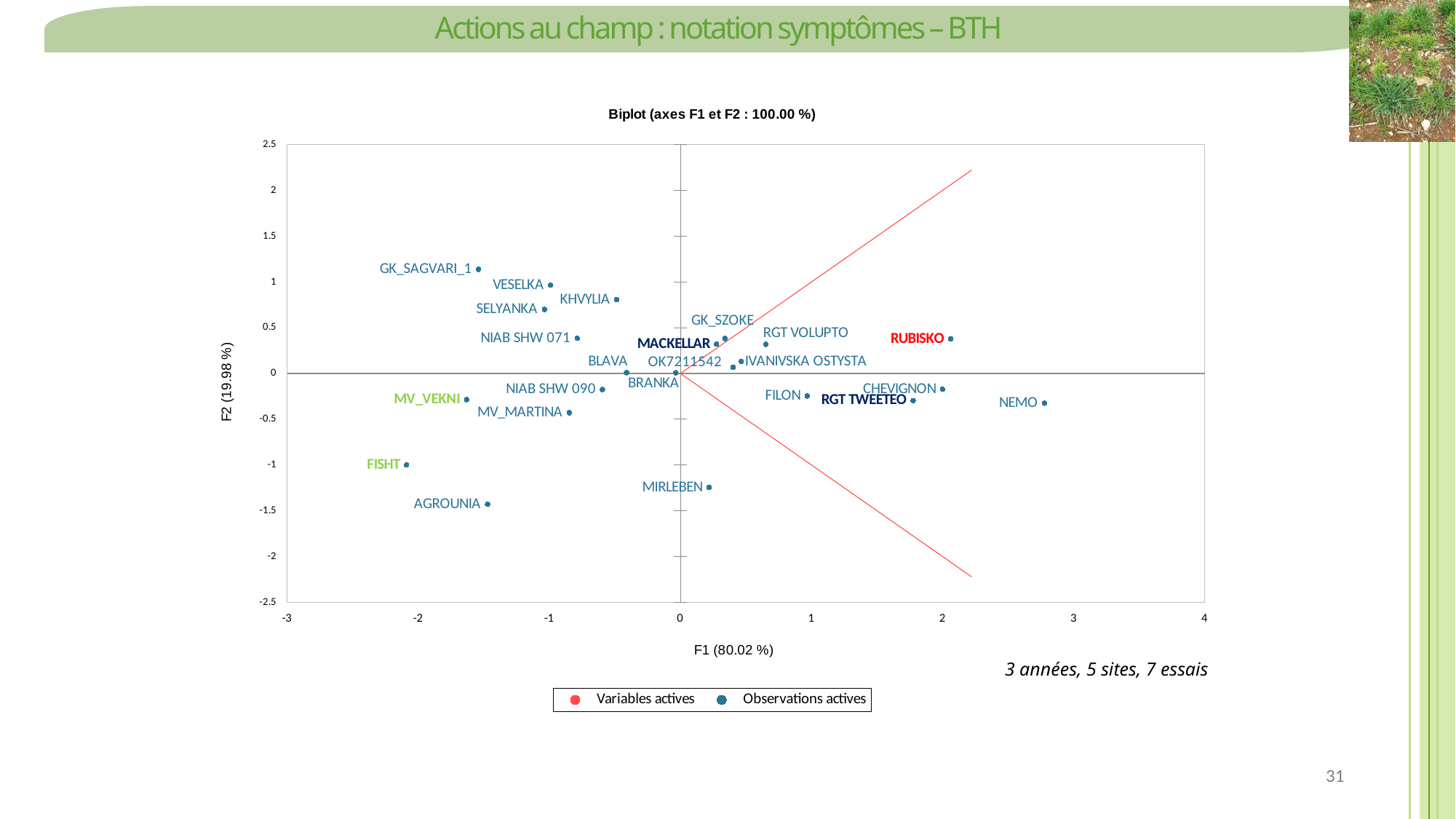
What is the title of the chart? Biplot (axes F1 et F2 : 100.00 %) What is the label of the horizontal axis? F1 (80.02 %) How many entries does the chart legend list? 2 Which labelled point has the lowest F2 value? AGROUNIA Is the F1 value for NEMO greater or less than 2? greater Is the F2 value for KHVYLIA greater or less than 0.5? greater What kind of chart is shown on the slide? Scatter plot (biplot) Which has the higher F2 value, GK_SAGVARI_1 or MIRLEBEN? GK_SAGVARI_1 Which labelled point has the highest F1 value? NEMO Which labelled point has the lowest F1 value? FISHT Which has the higher F1 value, FISHT or RUBISKO? RUBISKO Is the F2 value for AGROUNIA greater or less than -1? less